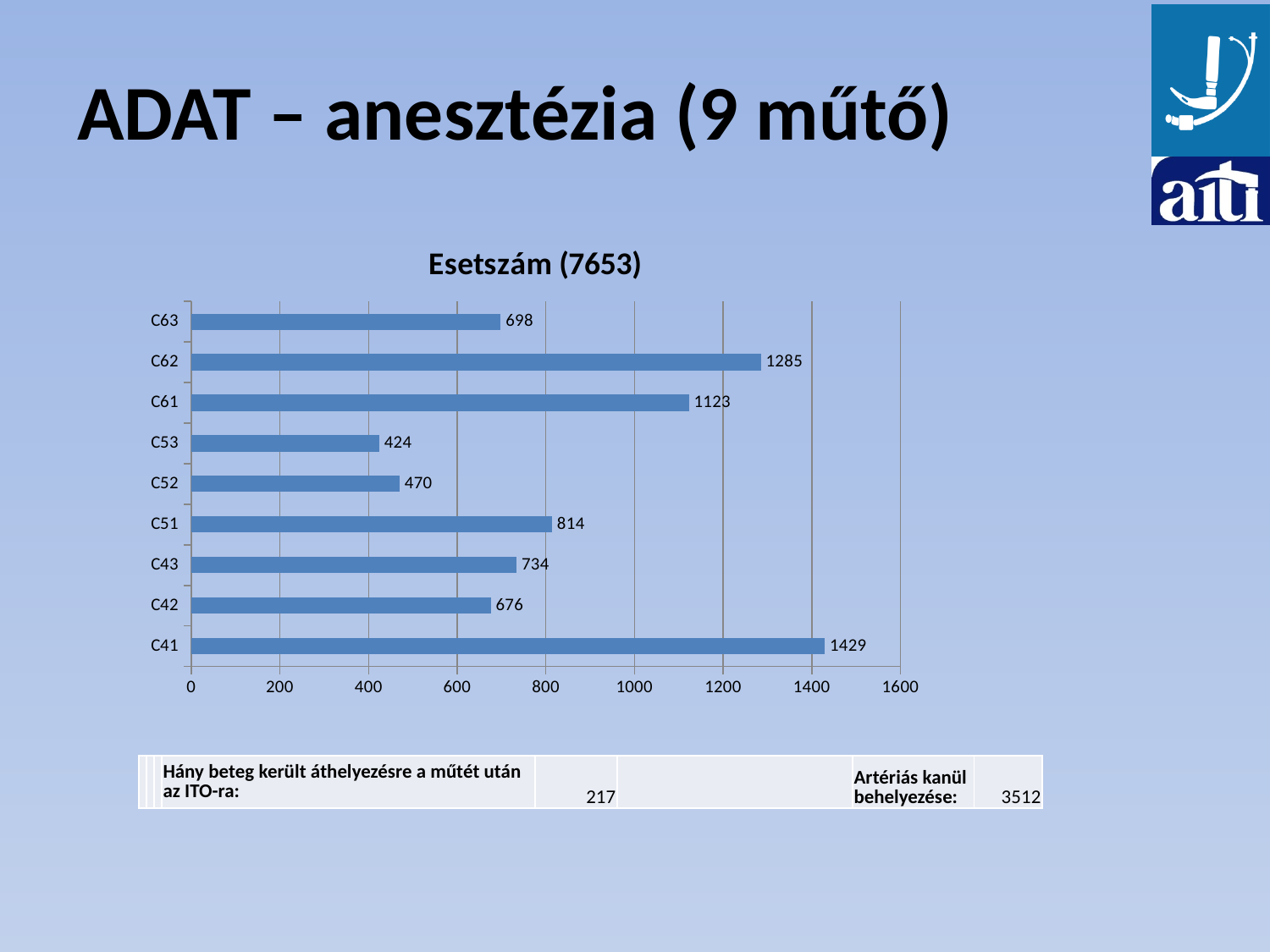
What is the difference between the values for C62 and C61? 162 What is the difference between the values for C52 and C53? 46 How many categories are shown in the chart? 9 Is the value for C51 greater or less than 800? greater What is the value for C41? 1429 Which is larger, the value for C43 or the value for C42? C43 What is the value for C62? 1285 Which category has the highest value? C41 What kind of chart is shown on the slide? bar chart What is the value for C53? 424 What is the title of the chart? Esetszám (7653) Which category has the lowest value? C53